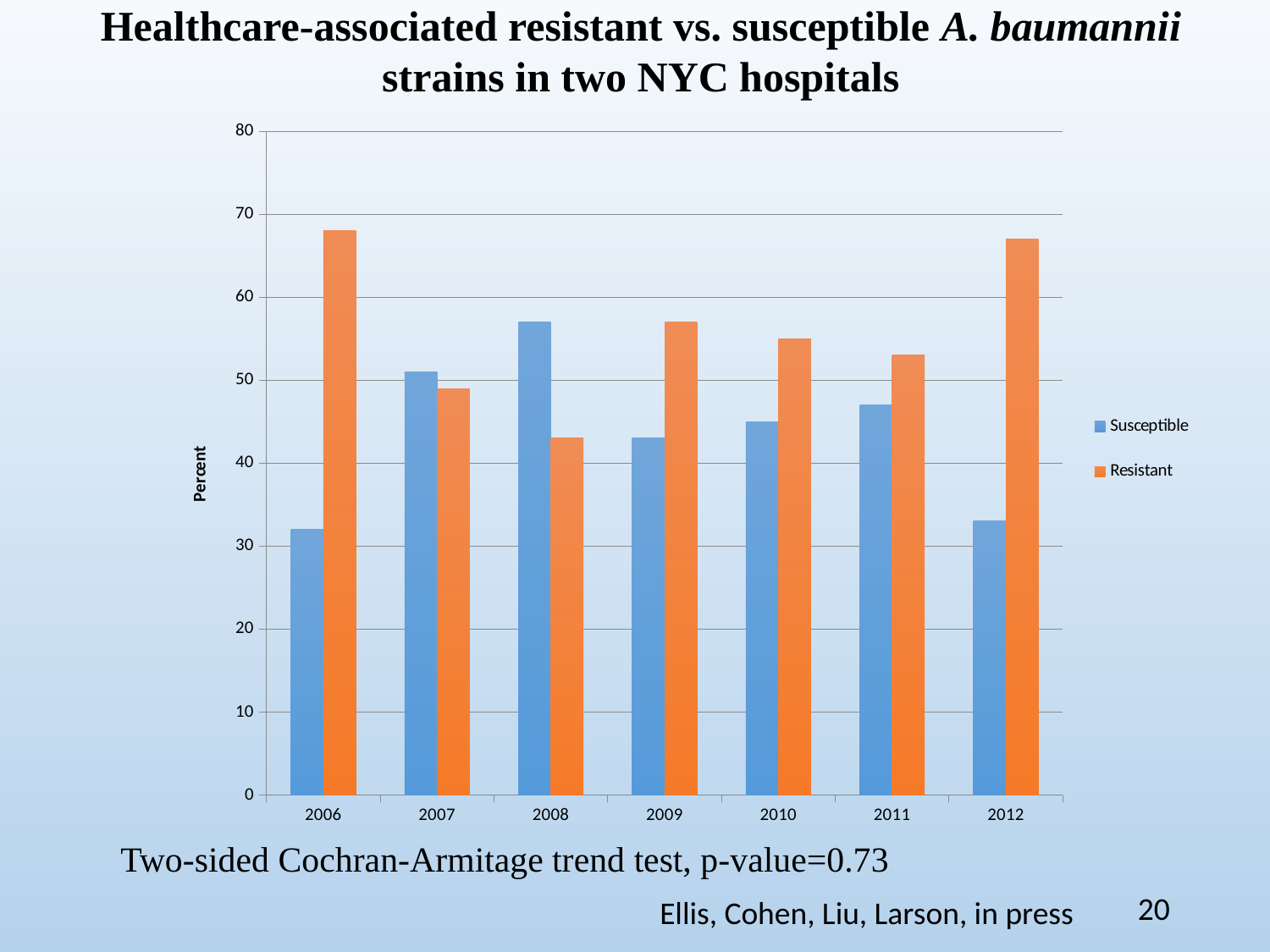
Which year has the lowest Resistant value? 2008 How many series does the legend list? 2 What is the label on the vertical axis? Percent In 2011, which is larger, the Susceptible or the Resistant value? Resistant Is the Susceptible value for 2008 greater or less than 50? greater How many years are shown on the x axis? 7 Is the Susceptible value for 2006 greater or less than 40? less Is the Resistant value for 2006 greater or less than 60? greater Which year has the highest Susceptible value? 2008 In 2008, which is larger, the Susceptible or the Resistant value? Susceptible What kind of chart is shown on the slide? bar chart